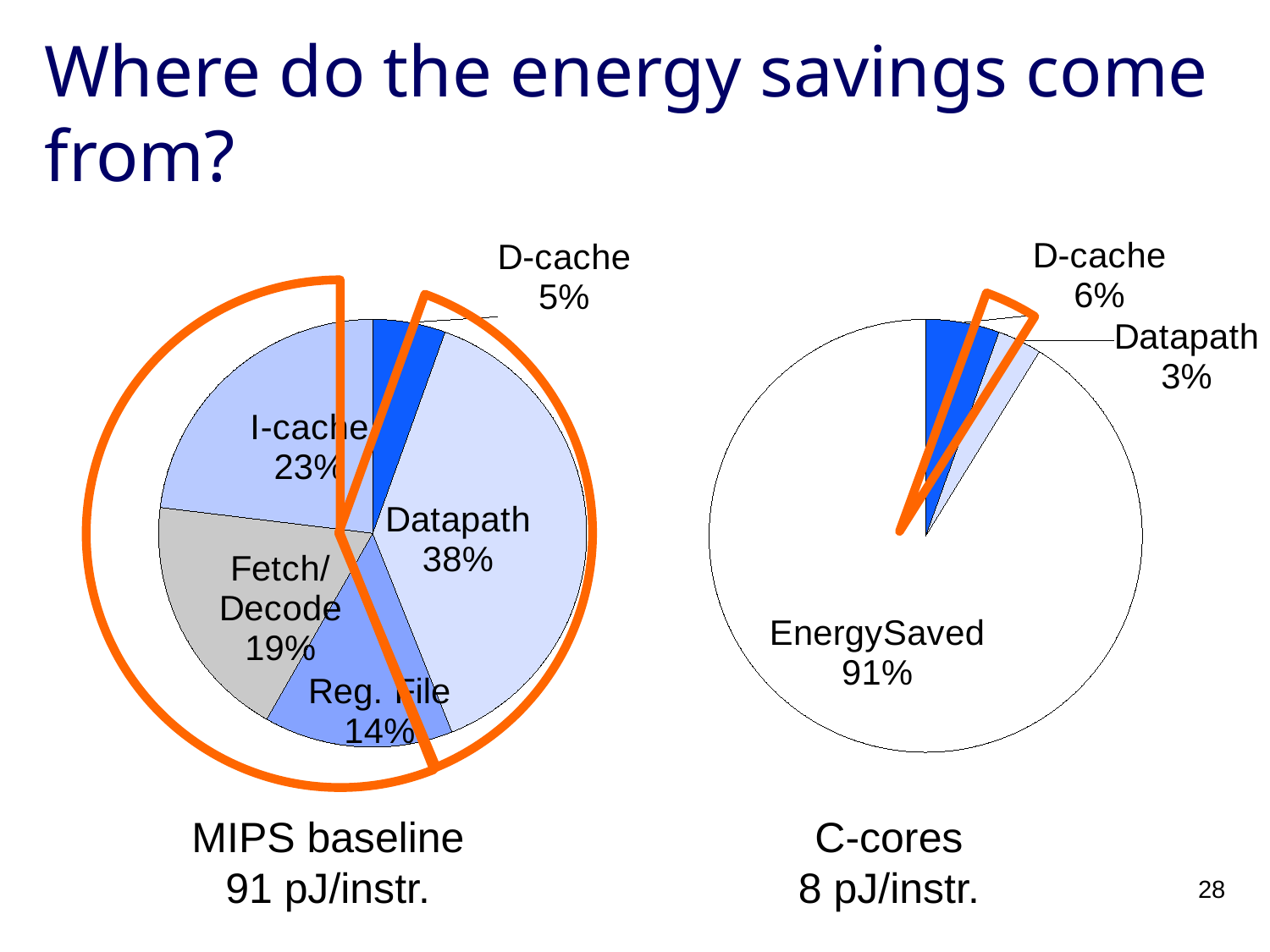
In the C-cores pie chart, which is larger, D-cache or Datapath? D-cache In the MIPS baseline pie chart, what share does Reg. File have? 14% In the MIPS baseline pie chart, which slice is the smallest? D-cache In the MIPS baseline pie chart, what share does Fetch/Decode have? 19% In the MIPS baseline pie chart, which slice is the largest? Datapath In the C-cores pie chart, what share does EnergySaved have? 91% In the MIPS baseline pie chart, what is the difference between the Datapath share and the I-cache share? 15% In the MIPS baseline pie chart, how many slices are there? 5 What kind of chart is used on the right side of the slide for C-cores? Pie chart